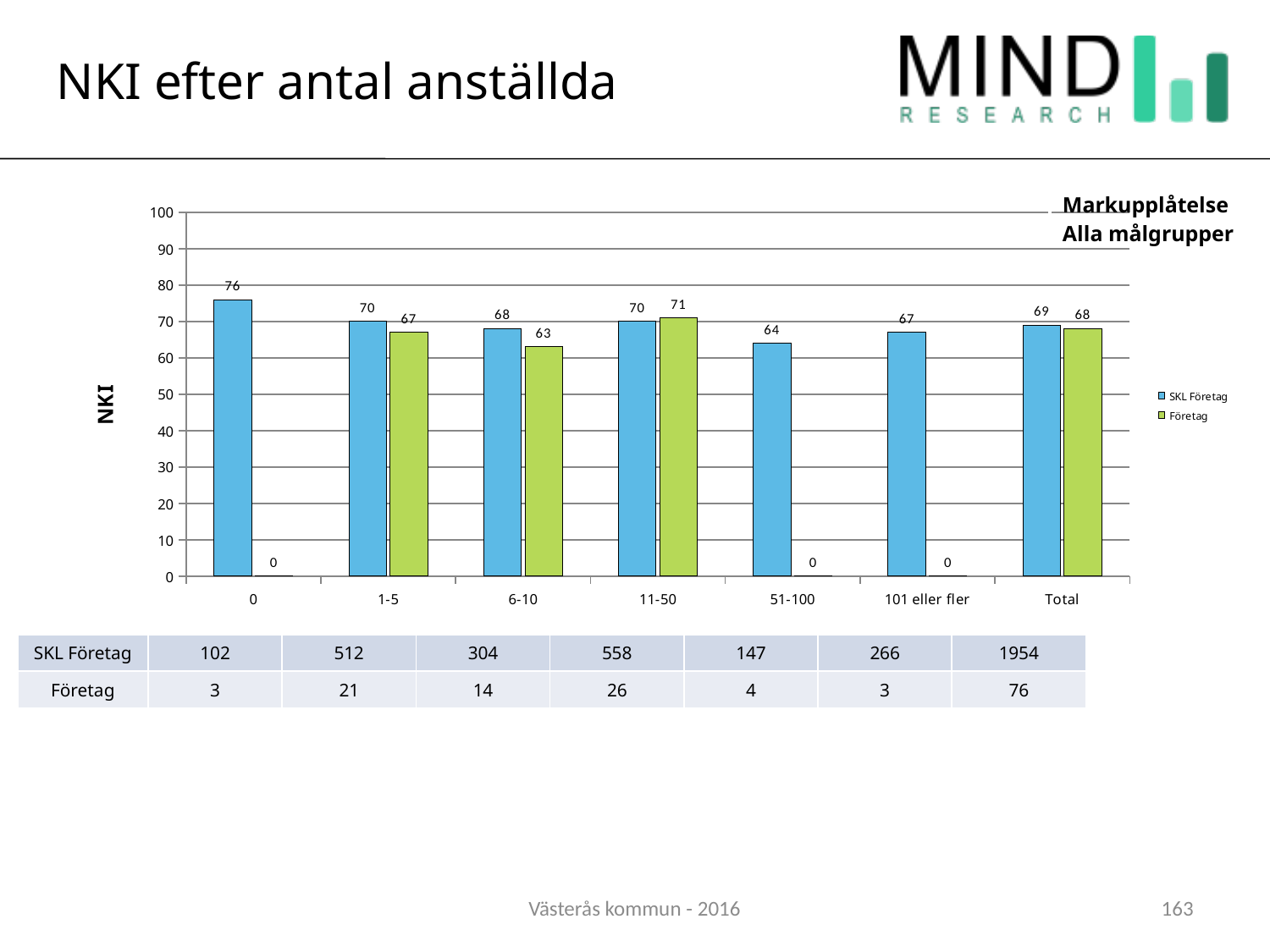
In the 11-50 employees category, which series has the higher NKI value, SKL Företag or Företag? Företag What is the NKI value for SKL Företag in the 0 employees category? 76 What is the NKI value for Företag in the 6-10 employees category? 63 How many categories are shown on the x axis of the chart? 7 Which category has the lowest NKI value for SKL Företag? 51-100 What kind of chart is shown on the slide? Bar chart Is the NKI value for SKL Företag in the 51-100 category greater or less than 70? less How many series does the chart legend list? 2 What is the difference between the SKL Företag and Företag NKI values in the 1-5 employees category? 3 What is the NKI value for Företag in the 11-50 employees category? 71 What is the NKI value for SKL Företag in the Total category? 69 Which category has the highest NKI value for SKL Företag? 0